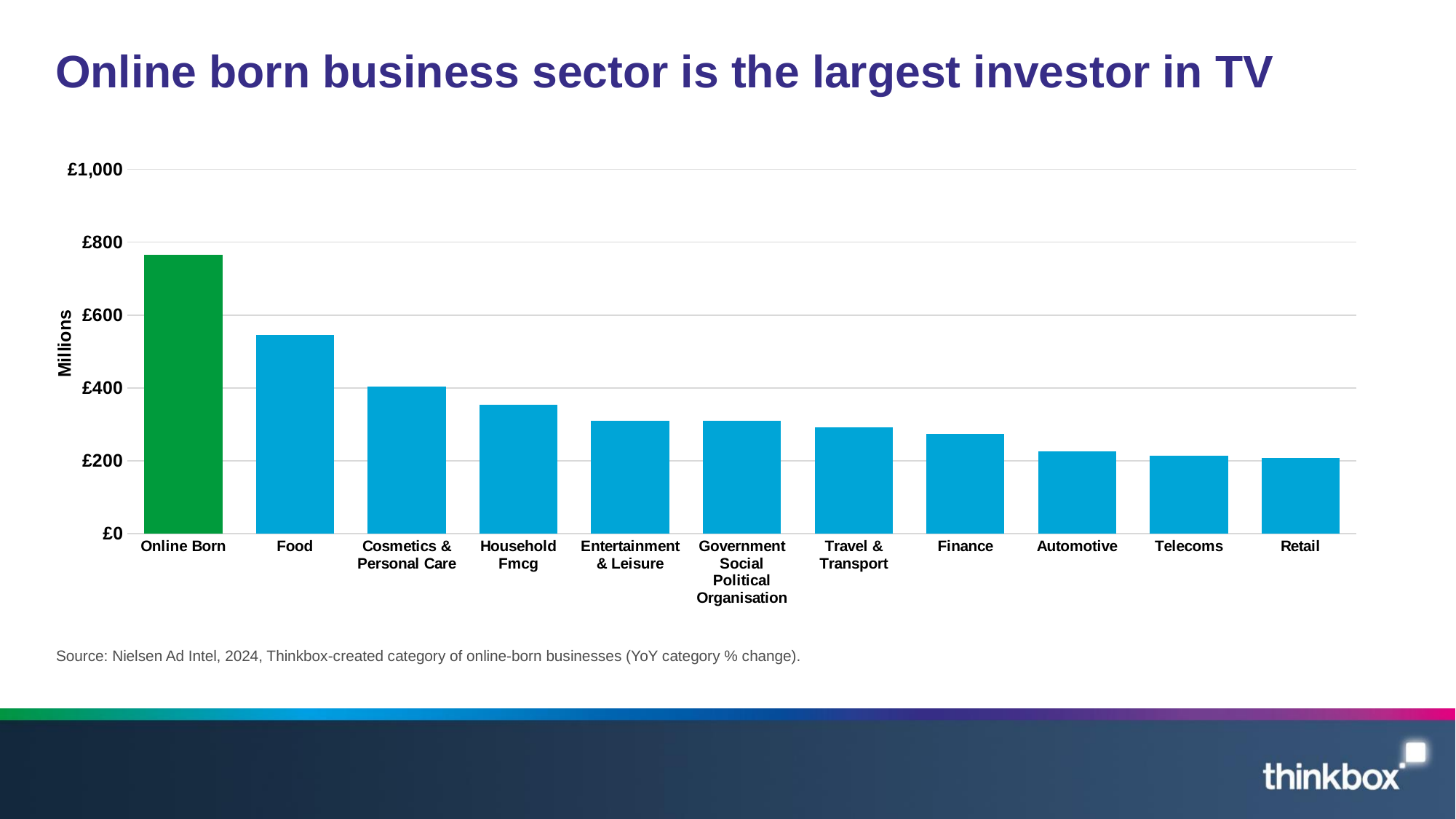
What kind of chart is shown on the slide? bar chart What colour is the Online Born bar? green Do the bar values rise or fall moving from left to right along the x axis? fall Which is larger, the value for Online Born or the value for Food? Online Born How many sectors are shown on the x axis of the chart? 11 Is the value for Online Born greater or less than £600? greater Is the value for Food greater or less than £600? less Which is larger, the value for Food or the value for Cosmetics & Personal Care? Food Is the value for Food greater or less than £400? greater Which sector has the highest TV investment in the chart? Online Born